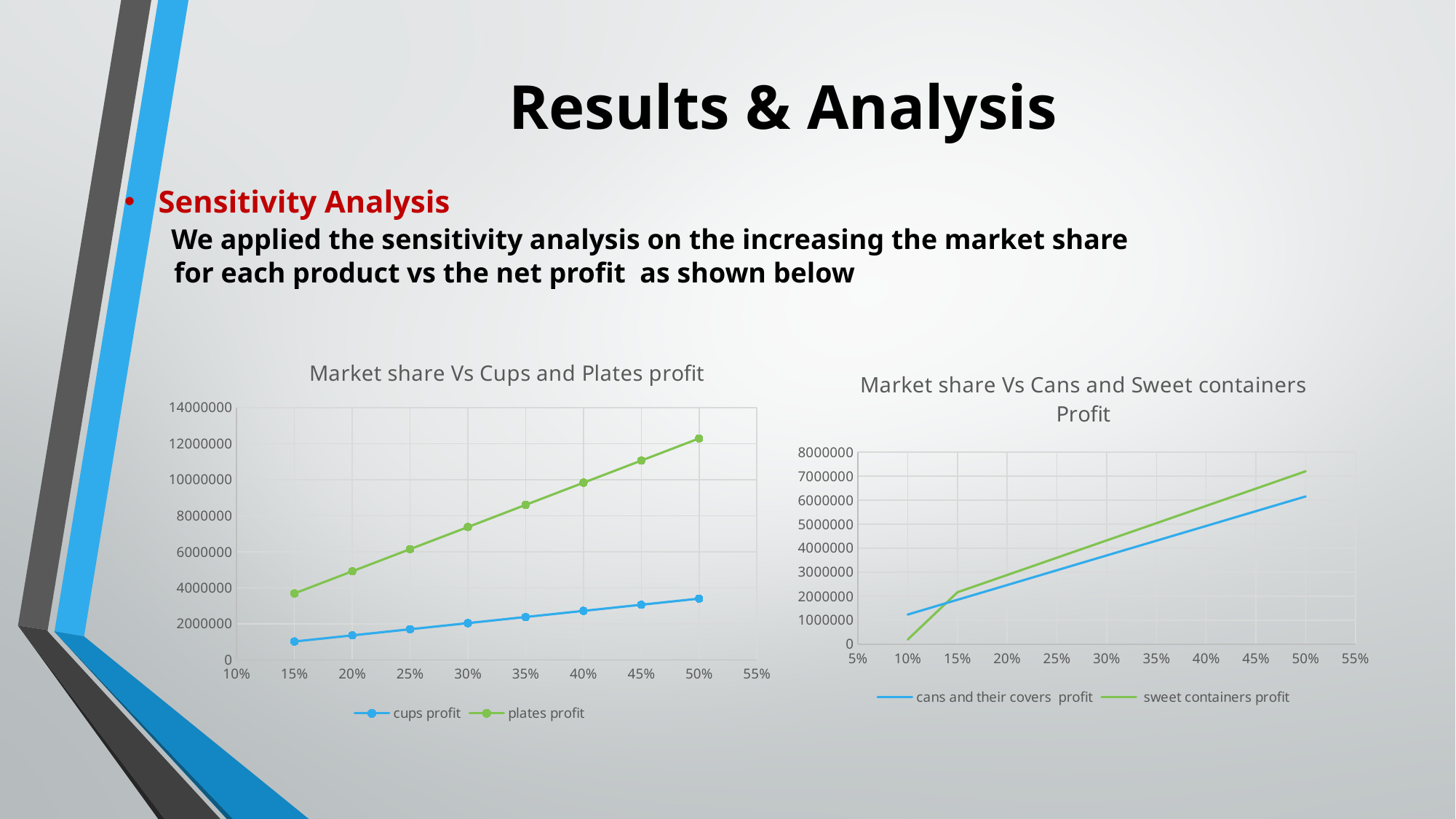
In the 'Market share Vs Cans and Sweet containers Profit' chart, what colour is the line for sweet containers profit? green In the 'Market share Vs Cans and Sweet containers Profit' chart, which series is higher at 10% market share, cans and their covers profit or sweet containers profit? cans and their covers profit In the 'Market share Vs Cups and Plates profit' chart, is the plates profit at 30% greater or less than 8000000? less In the 'Market share Vs Cups and Plates profit' chart, which series is higher at 50% market share, cups profit or plates profit? plates profit In the 'Market share Vs Cups and Plates profit' chart, is the cups profit at 50% greater or less than 4000000? less In the 'Market share Vs Cups and Plates profit' chart, at which market share is plates profit highest? 50% What kind of chart is the 'Market share Vs Cups and Plates profit' chart? line chart How many series does the legend of the 'Market share Vs Cups and Plates profit' chart list? 2 How many data points are plotted for the cups profit series in the 'Market share Vs Cups and Plates profit' chart? 8 How many series does the legend of the 'Market share Vs Cans and Sweet containers Profit' chart list? 2 In the 'Market share Vs Cans and Sweet containers Profit' chart, is the sweet containers profit at 10% greater or less than 1000000? less In the 'Market share Vs Cups and Plates profit' chart, does plates profit rise or fall as market share increases? rise